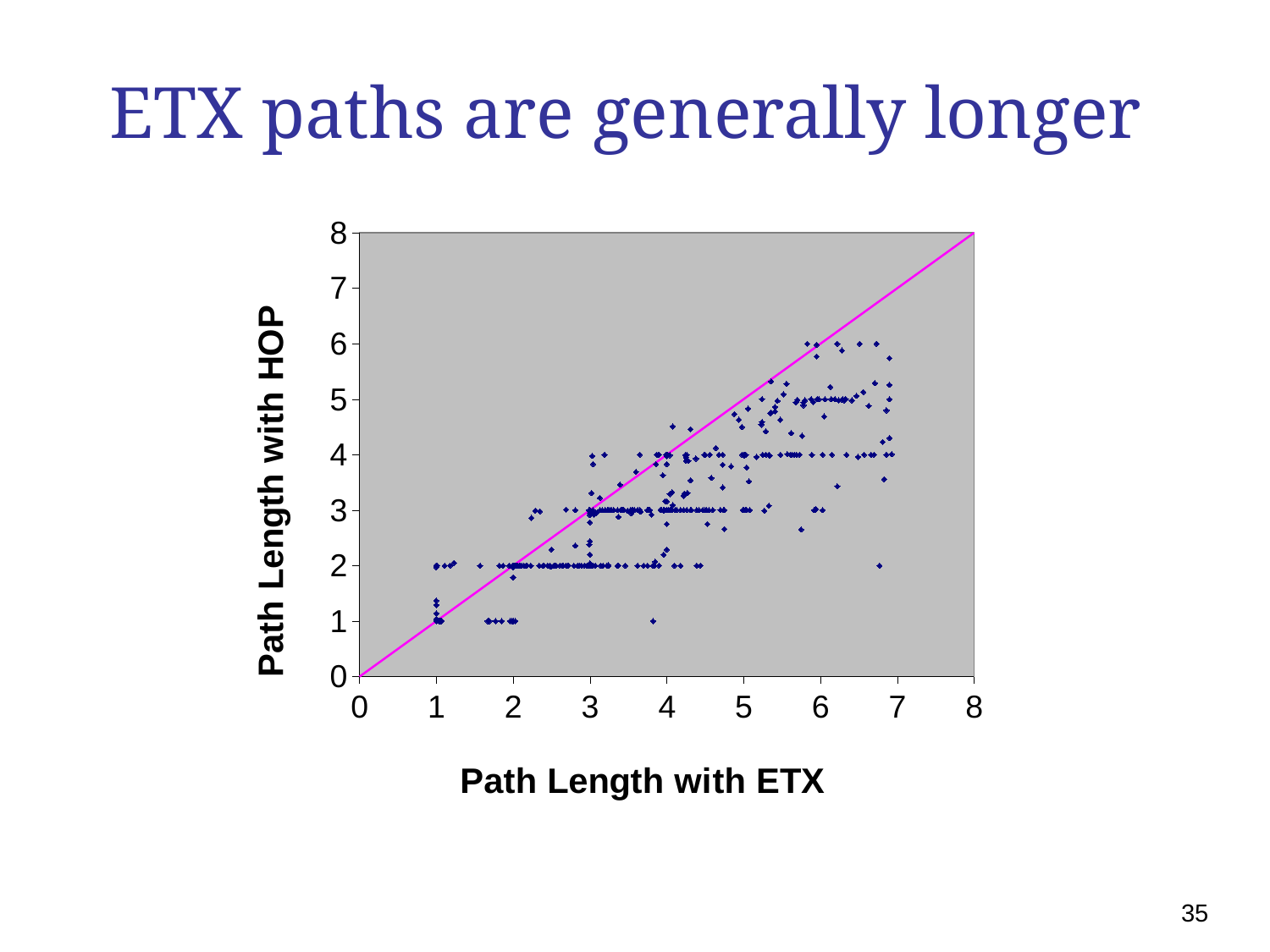
What is the highest tick value shown on the horizontal axis? 8 What is the lowest tick value shown on the horizontal axis? 0 What is the label of the vertical axis of the chart? Path Length with HOP Do the Path Length with HOP values generally rise or fall as Path Length with ETX increases? rise What is the highest tick value shown on the vertical axis? 8 Is the largest Path Length with HOP value plotted greater or less than 7? less What kind of chart is shown on the slide? scatter plot Is the smallest Path Length with ETX value plotted greater or less than 2? less Do most of the plotted points lie above or below the diagonal line? below What is the label of the horizontal axis of the chart? Path Length with ETX Is the largest Path Length with ETX value plotted greater or less than 6? greater